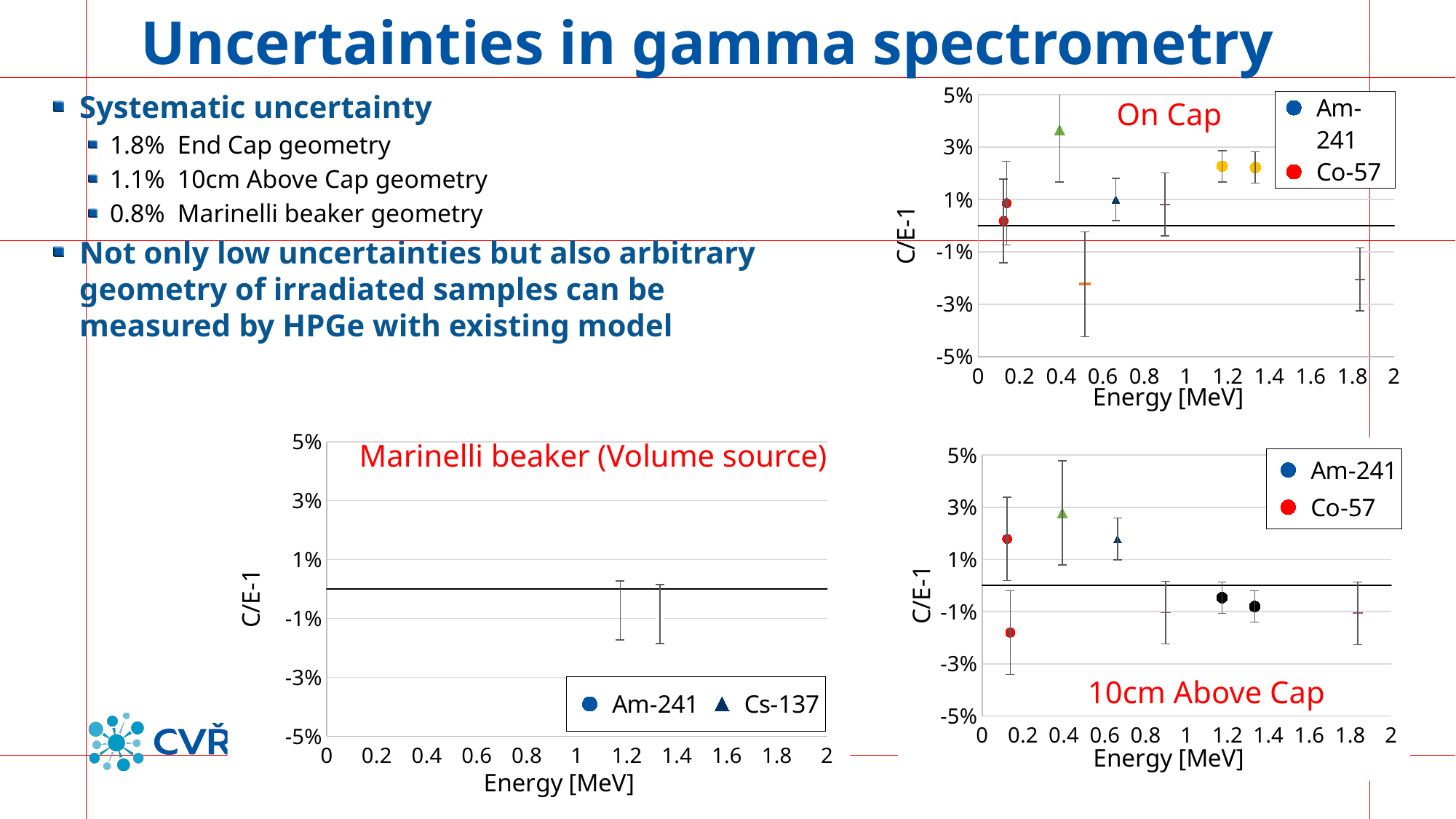
In the "10cm Above Cap" chart, is the value of the green triangle point near 0.4 MeV greater or less than 1%? greater In the "On Cap" chart, which is larger: the value of the green triangle point near 0.4 MeV or the value of the point near 1.8 MeV? the green triangle point near 0.4 MeV What kind of chart is the "On Cap" chart? scatter chart What is the x-axis label of the "10cm Above Cap" chart? Energy [MeV] How many series does the legend of the "On Cap" chart list? 2 In the "On Cap" chart, is the value of the green triangle point near 0.4 MeV greater or less than 3%? greater In the "On Cap" chart, is the value of the point near 1.8 MeV greater or less than -1%? less How many series does the legend of the "Marinelli beaker (Volume source)" chart list? 2 Which two series are listed in the legend of the "Marinelli beaker (Volume source)" chart? Am-241 and Cs-137